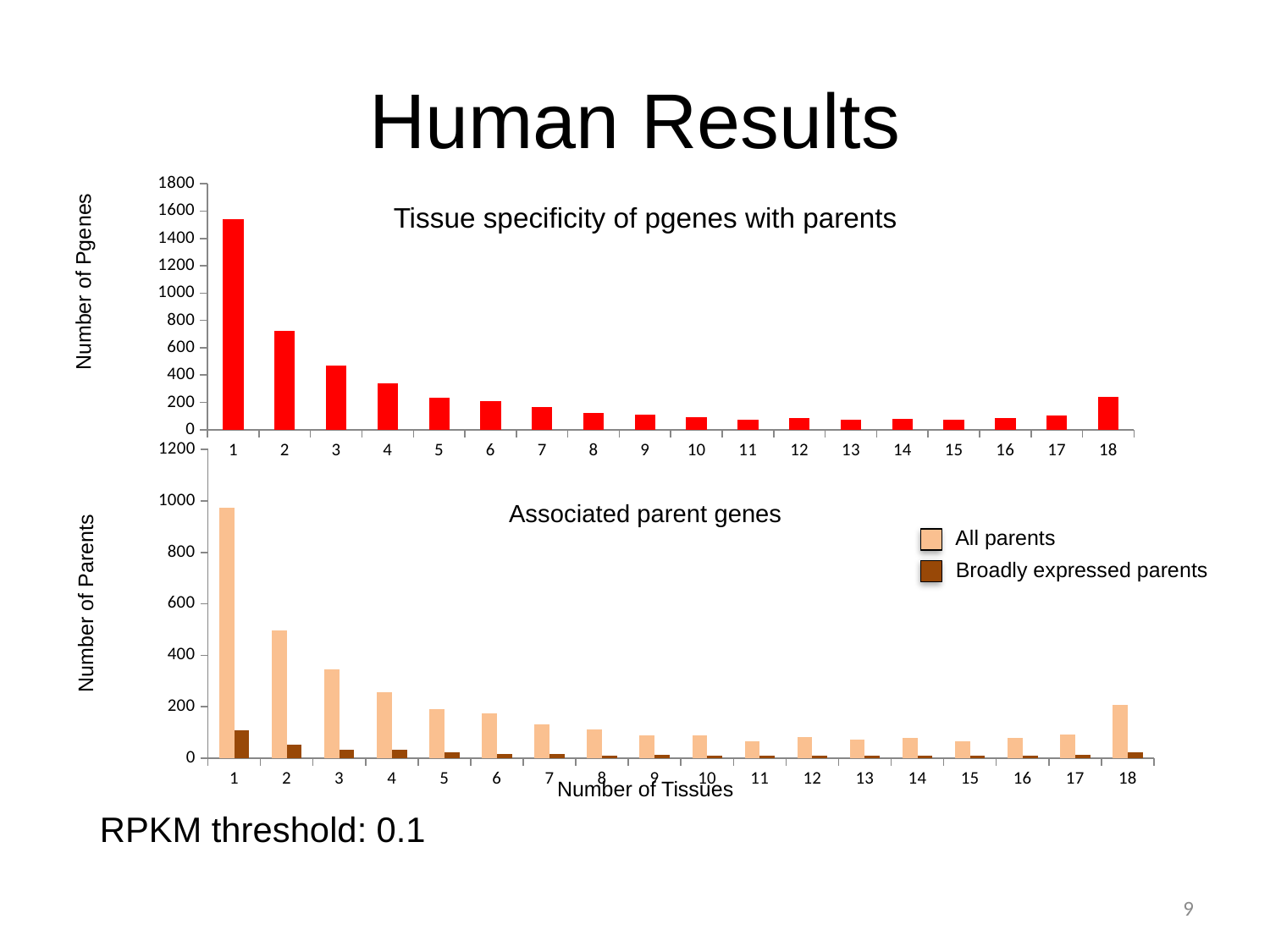
In the top chart, 'Tissue specificity of pgenes with parents', which is larger, the value for 2 tissues or the value for 18 tissues? 2 tissues In the top chart, 'Tissue specificity of pgenes with parents', is the value for 2 tissues greater or less than 600? greater In the top chart, 'Tissue specificity of pgenes with parents', which number of tissues has the highest number of pgenes? 1 In the bottom chart, 'Associated parent genes', which is larger at 1 tissue, 'All parents' or 'Broadly expressed parents'? All parents In the bottom chart, 'Associated parent genes', is the 'All parents' value for 1 tissue greater or less than 800? greater In the bottom chart, 'Associated parent genes', how many series does the legend list? 2 In the top chart, 'Tissue specificity of pgenes with parents', do the values rise or fall from 1 tissue to 4 tissues? fall In the bottom chart, 'Associated parent genes', what is the label of the y axis? Number of Parents In the top chart, 'Tissue specificity of pgenes with parents', is the value for 1 tissue greater or less than 1400? greater In the bottom chart, 'Associated parent genes', what kind of chart is it? bar chart In the top chart, 'Tissue specificity of pgenes with parents', how many number-of-tissues categories are shown on the x axis? 18